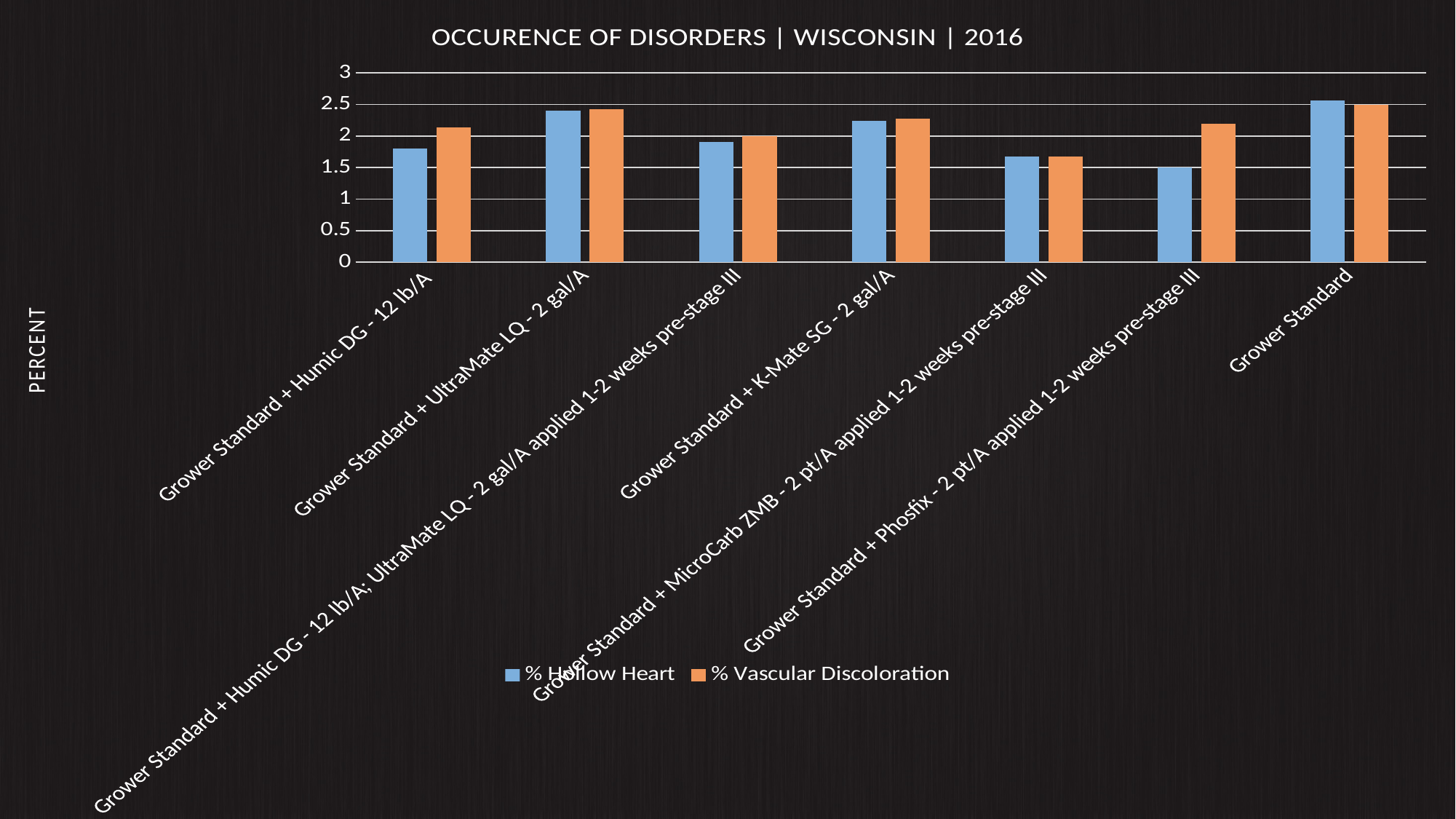
Is the % Hollow Heart value for Grower Standard + Humic DG - 12 lb/A greater or less than 2? less How many series does the legend list? 2 Which treatment has the lowest % Hollow Heart? Grower Standard + Phosfix - 2 pt/A applied 1-2 weeks pre-stage III Which treatment has the highest % Hollow Heart? Grower Standard Which treatment has the lowest % Vascular Discoloration? Grower Standard + MicroCarb ZMB - 2 pt/A applied 1-2 weeks pre-stage III How many treatment categories are shown on the x axis? 7 What is the label on the vertical axis? PERCENT What is the title of the chart? OCCURENCE OF DISORDERS | WISCONSIN | 2016 Is the % Hollow Heart value for Grower Standard + UltraMate LQ - 2 gal/A greater or less than 2? greater Is the % Vascular Discoloration value for Grower Standard + Phosfix - 2 pt/A applied 1-2 weeks pre-stage III greater or less than 2? greater What kind of chart is shown on the slide? bar chart For Grower Standard + Humic DG - 12 lb/A, which is larger: % Hollow Heart or % Vascular Discoloration? % Vascular Discoloration